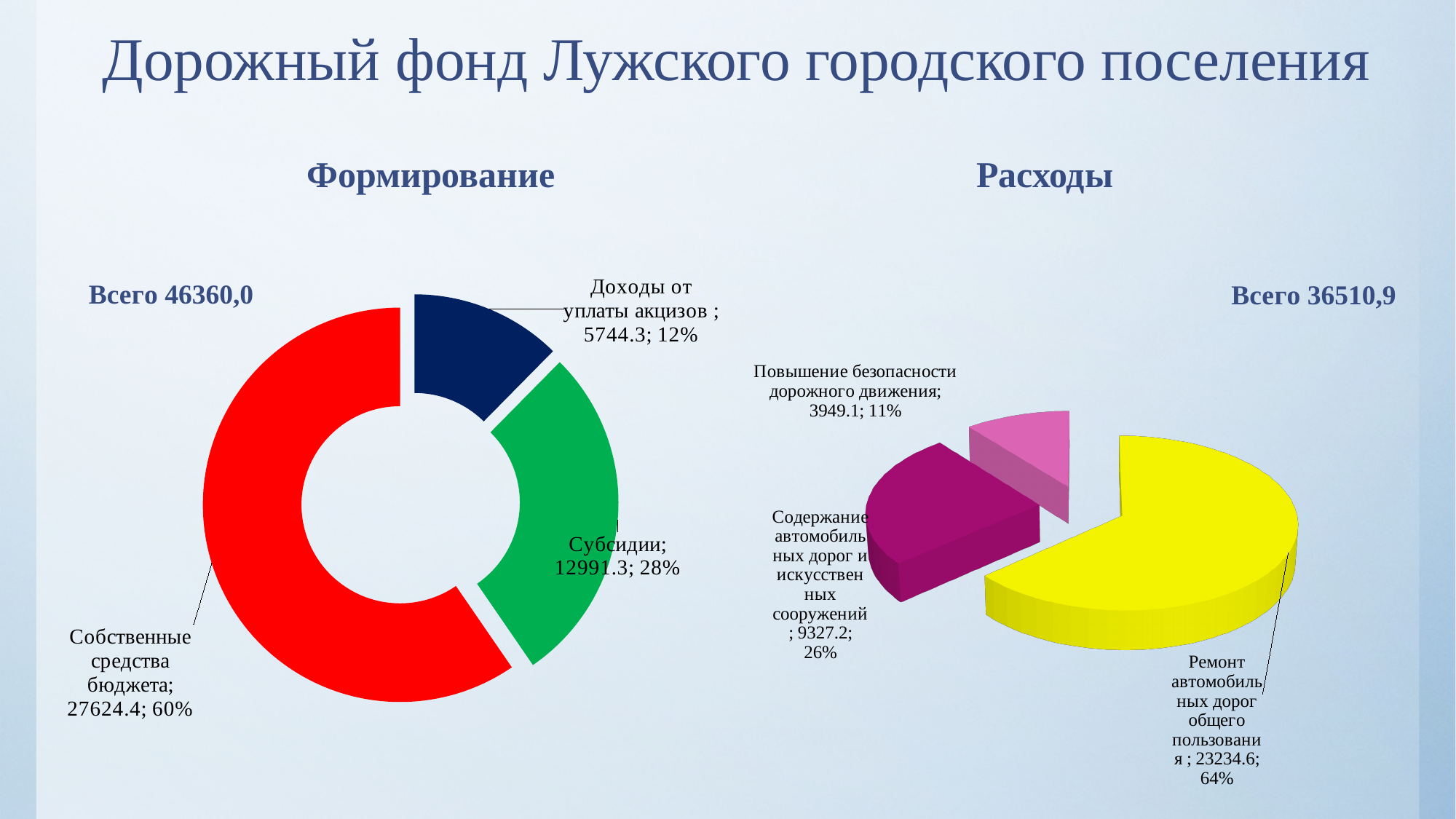
What kind of chart is the "Расходы" chart? Pie chart In the "Расходы" chart, which is larger: "Содержание автомобильных дорог и искусственных сооружений" or "Повышение безопасности дорожного движения"? Содержание автомобильных дорог и искусственных сооружений In the "Формирование" chart, what is the difference between "Собственные средства бюджета" and "Субсидии"? 14633.1 In the "Формирование" chart, which category has the smallest value? Доходы от уплаты акцизов In the "Расходы" chart, which category has the largest value? Ремонт автомобильных дорог общего пользования What kind of chart is the "Формирование" chart? Doughnut chart What total ("Всего") is shown next to the "Расходы" chart? 36510,9 How many categories does the "Формирование" chart show? 3 In the "Формирование" chart, what share of the total is "Собственные средства бюджета"? 60% In the "Расходы" chart, what share of the total is "Содержание автомобильных дорог и искусственных сооружений"? 26% In the "Расходы" chart, what is the value for "Повышение безопасности дорожного движения"? 3949.1 In the "Формирование" chart, what is the value for "Субсидии"? 12991.3